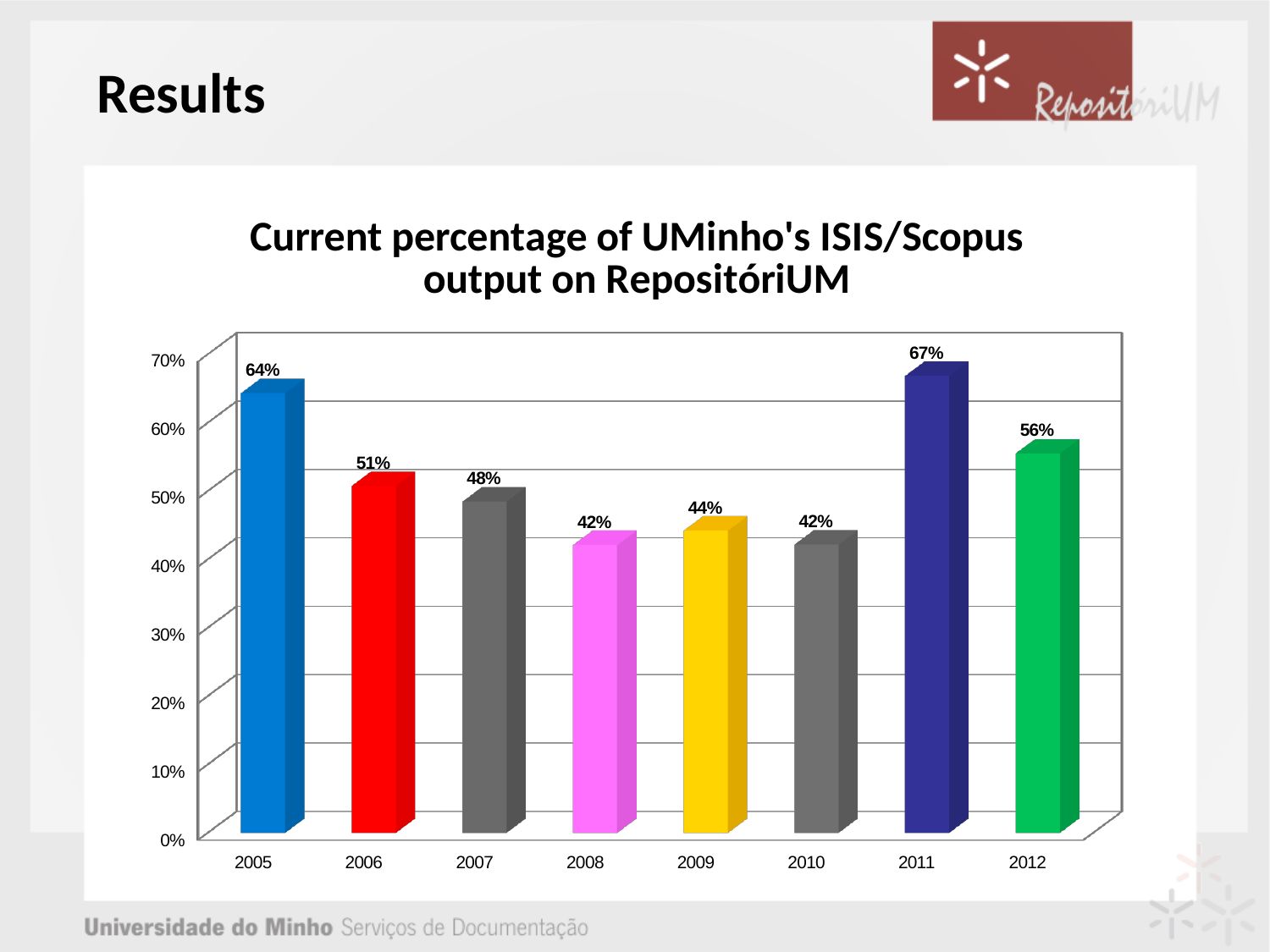
Is the value for 2010 greater or less than 50%? less What is the difference between the values for 2011 and 2005? 3% What is the value for 2009? 44% How many years are shown on the x axis? 8 What is the difference between the values for 2006 and 2007? 3% What kind of chart is shown? bar chart Do the values rise or fall from 2005 to 2008? fall What is the value for 2012? 56% What is the title of the chart? Current percentage of UMinho's ISIS/Scopus output on RepositóriUM Which year has the highest value? 2011 What is the value for 2005? 64% Which is larger, the value for 2006 or the value for 2012? 2012